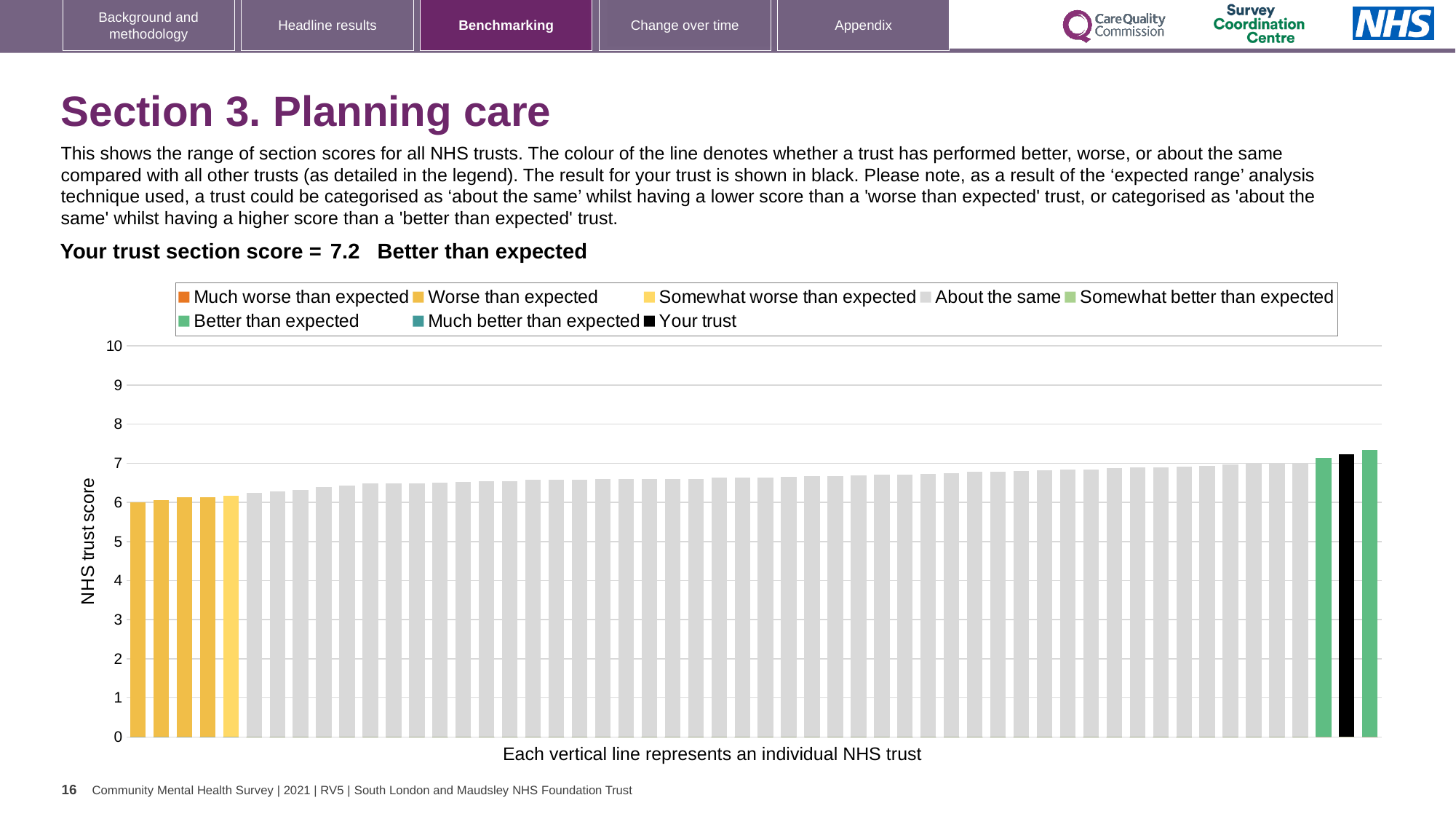
What is the title of the vertical axis? NHS trust score What colour is the bar representing your trust? black How many green bars are shown in the chart? 2 Is the value of the black bar (your trust) greater or less than 7? greater What kind of chart is shown on the slide? bar chart Is the value of the leftmost bar greater or less than 5? greater Is the value of the tallest bar greater or less than 8? less Which is larger, the black bar for your trust or the leftmost bar? the black bar for your trust What is the section score for your trust shown on the slide? 7.2 How many entries does the chart legend list? 8 How many yellow bars are shown at the left of the chart? 5 Do the bar values rise or fall from left to right along the x axis? rise